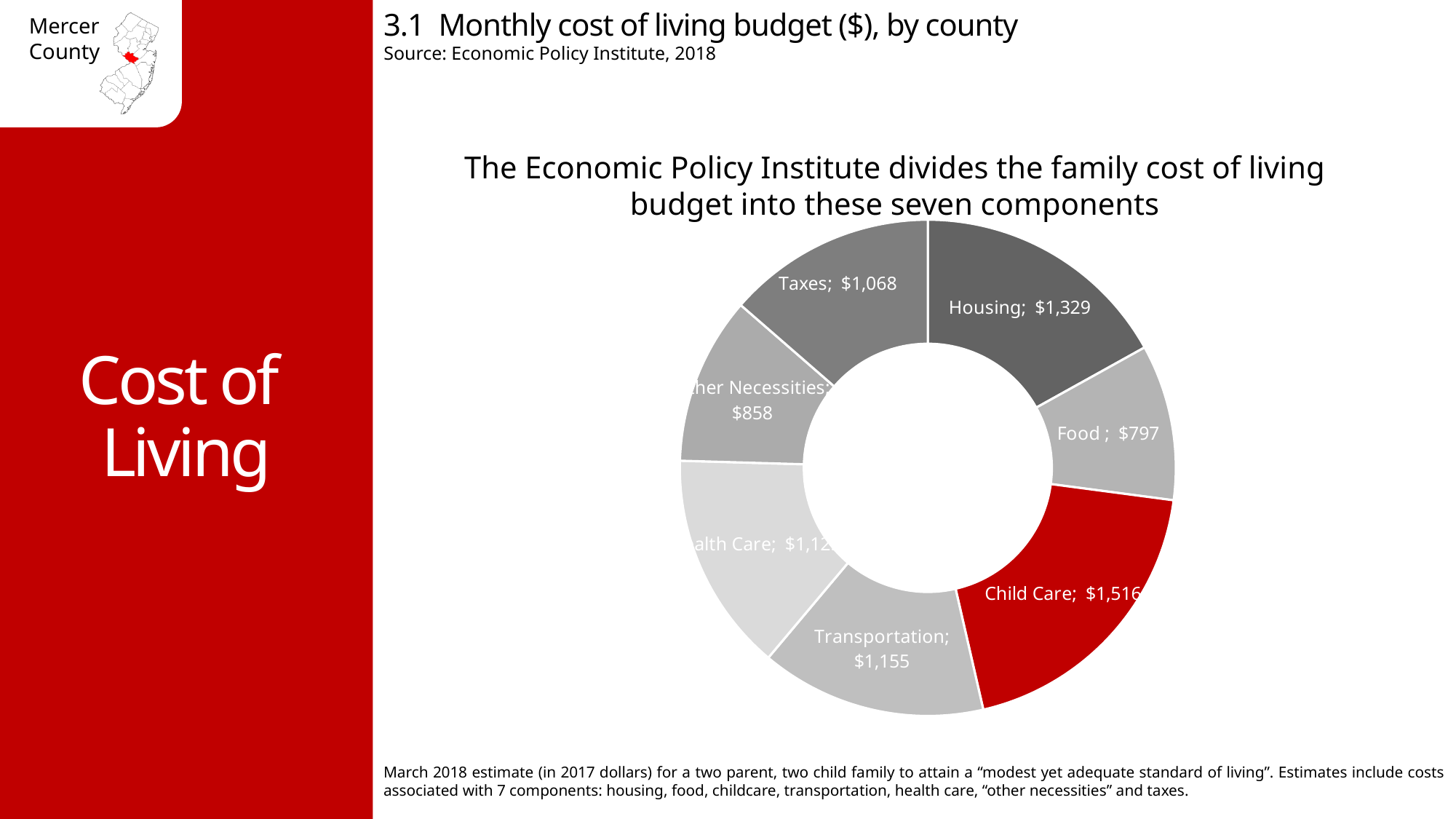
What is the monthly cost for Housing? $1,329 What is the monthly cost for Transportation? $1,155 What is the difference between the monthly cost of Housing and Food? $532 Which is larger, the monthly cost for Taxes or for Transportation? Transportation Which component has the lowest monthly cost? Food What kind of chart is shown on the slide? doughnut chart How many components are shown in the chart? 7 What is the monthly cost for Child Care? $1,516 What is the monthly cost for Taxes? $1,068 How much more is the monthly cost of Child Care than Housing? $187 Which component has the highest monthly cost? Child Care What is the monthly cost for Food? $797